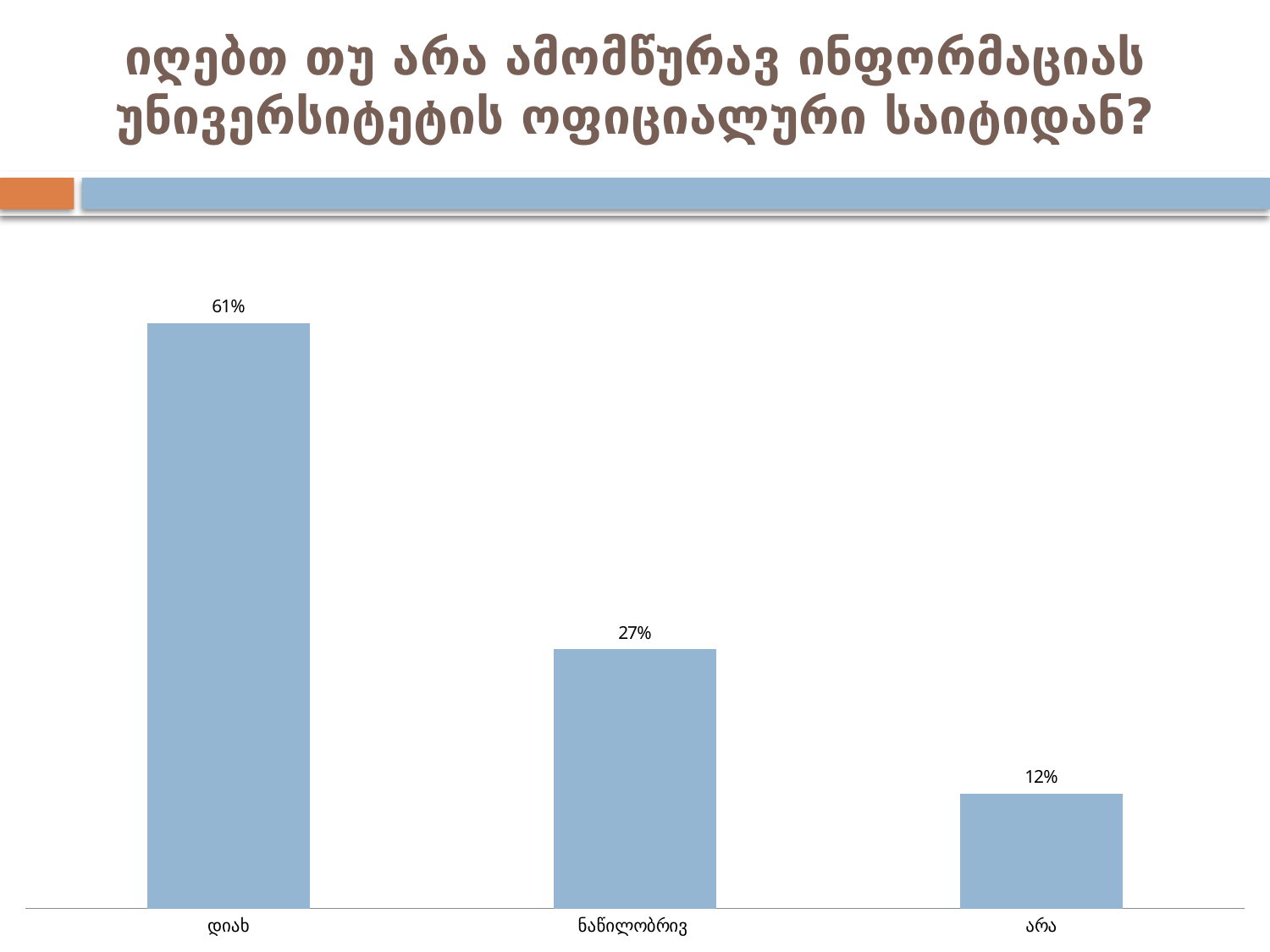
What is the value for დიახ? 61% What is the difference between the values for ნაწილობრივ and არა? 15% How many categories are shown on the chart? 3 Which is larger, the value for ნაწილობრივ or the value for არა? ნაწილობრივ Which category has the highest value? დიახ What kind of chart is shown on the slide? bar chart Do the values rise or fall from left to right across the categories? fall What is the value for ნაწილობრივ? 27% What is the value for არა? 12% What is the difference between the values for დიახ and ნაწილობრივ? 34% What colour are the bars on the chart? light blue Which category has the lowest value? არა